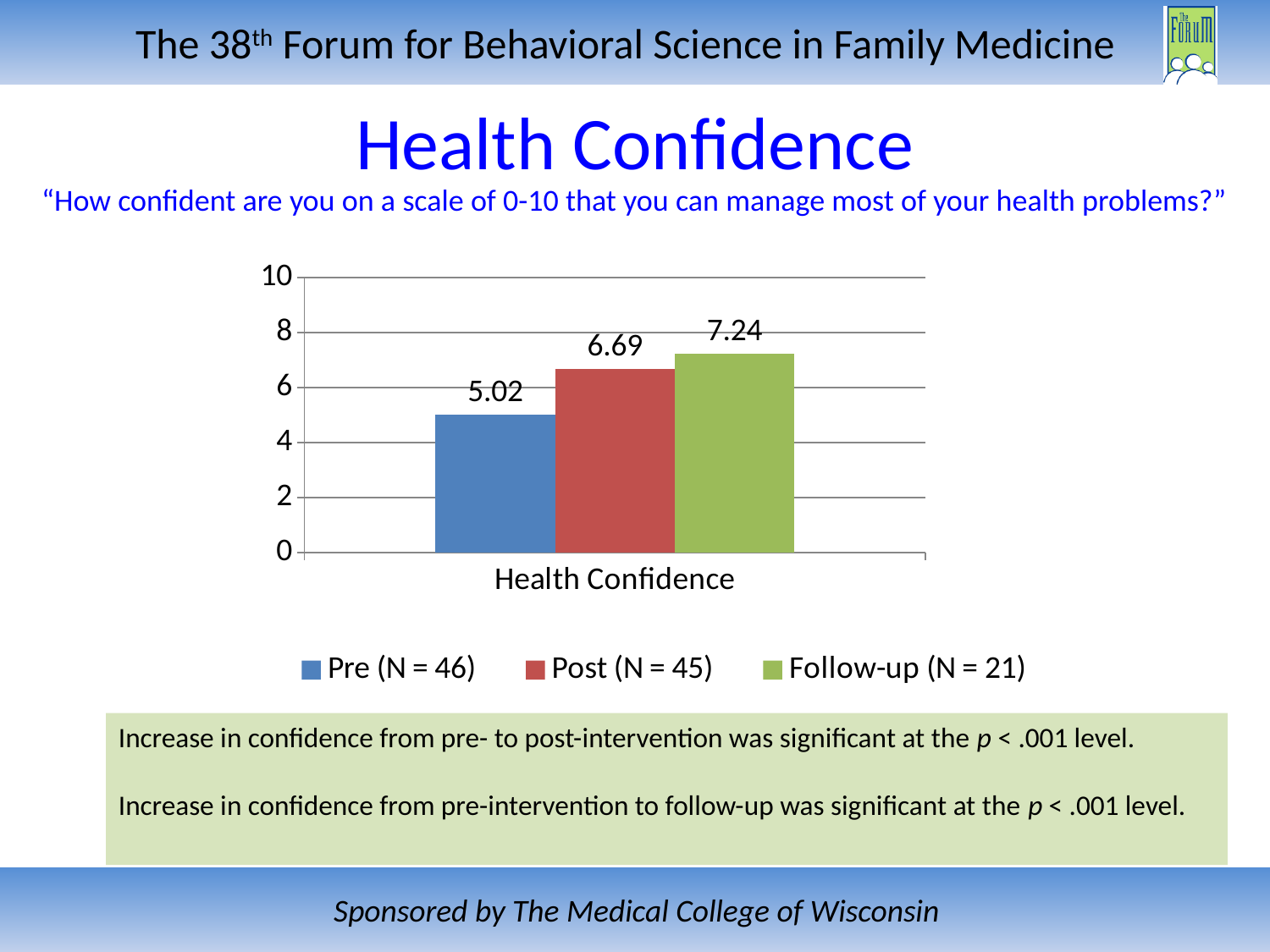
What is the value for Pre (N = 46) in the Health Confidence chart? 5.02 Which series has the highest value in the Health Confidence chart? Follow-up (N = 21) What is the value for Post (N = 45) in the Health Confidence chart? 6.69 What is the difference between the Post (N = 45) and Pre (N = 46) values? 1.67 What is the value for Follow-up (N = 21) in the Health Confidence chart? 7.24 What kind of chart is shown on the slide? bar chart Which is larger, the Pre (N = 46) value or the Post (N = 45) value? Post (N = 45) What is the difference between the Follow-up (N = 21) and Post (N = 45) values? 0.55 Which series has the lowest value in the Health Confidence chart? Pre (N = 46) What is the maximum value shown on the vertical axis of the chart? 10 How many series does the legend list? 3 Is the value for Follow-up (N = 21) greater or less than 8? less